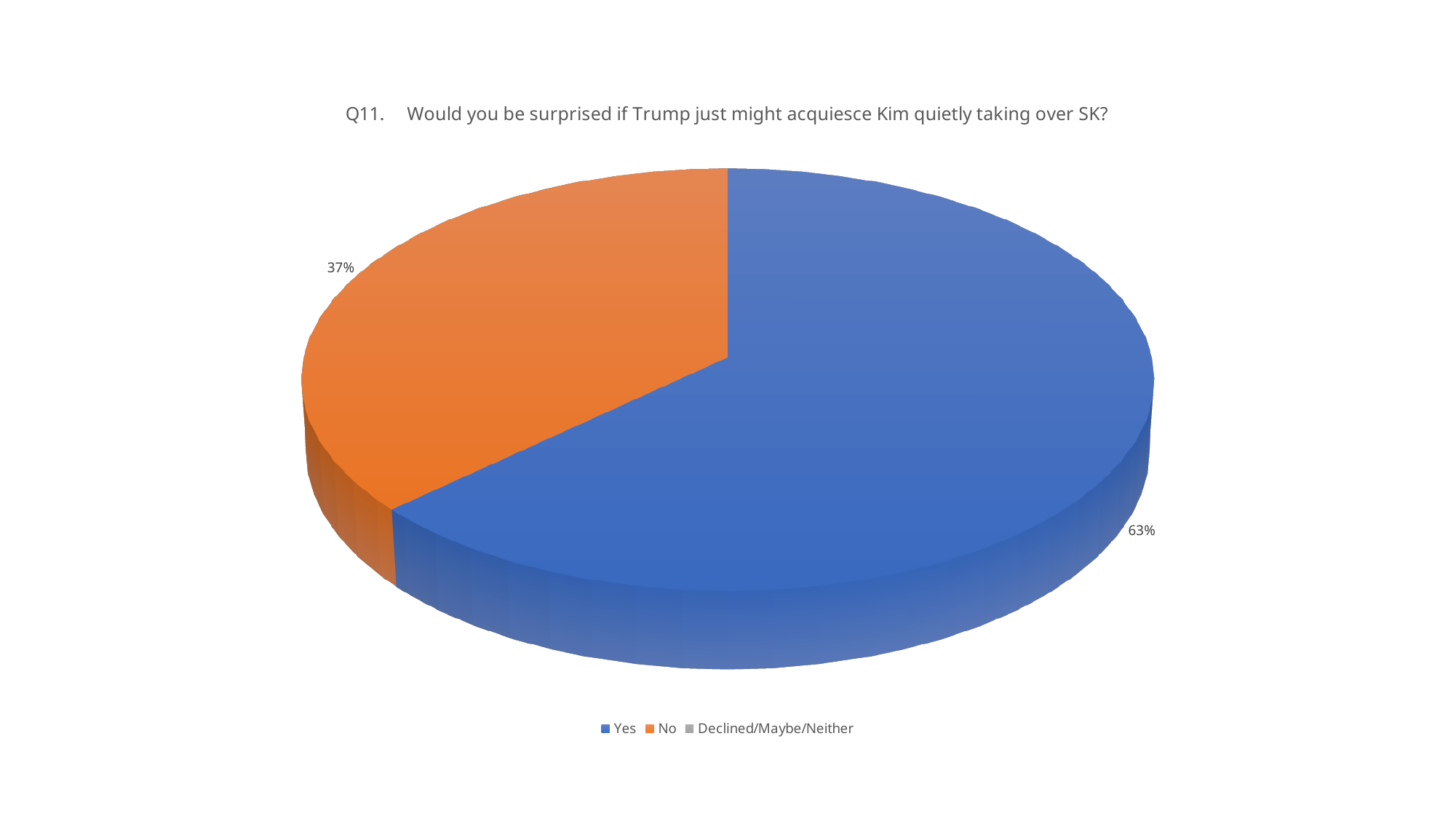
What share of the pie does the Yes slice represent? 63% What is the combined share of the Yes and No slices? 100% What colour is the Yes slice? Blue Which is larger, the Yes slice or the No slice? Yes Which category has the largest slice of the pie? Yes How many categories does the legend list? 3 What kind of chart is shown on the slide? Pie chart Which of the visible slices is the smallest? No What is the difference in percentage points between the Yes and No slices? 26 percentage points What is the title of the chart? Q11. Would you be surprised if Trump just might acquiesce Kim quietly taking over SK? What share of the pie does the No slice represent? 37%